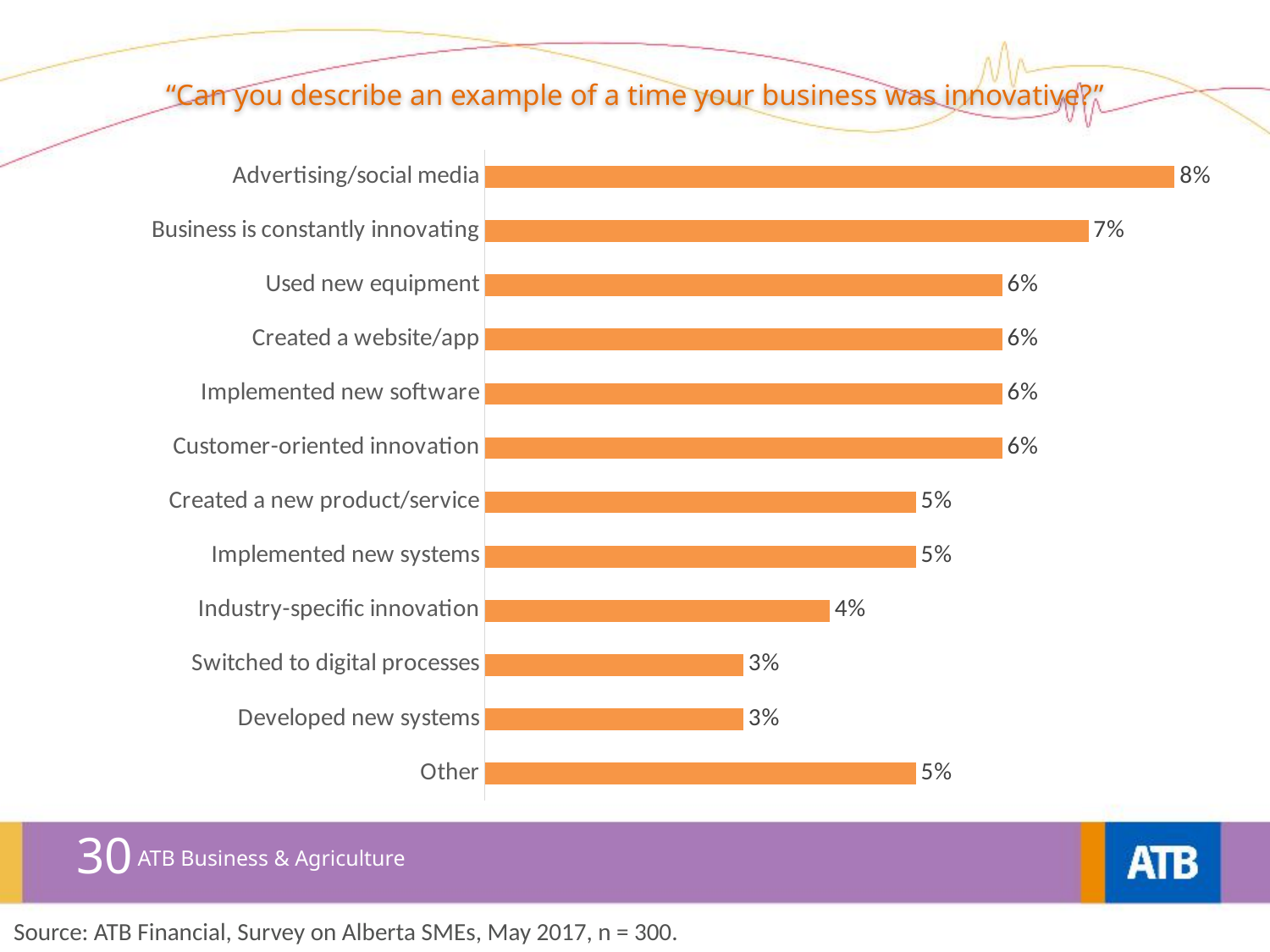
What is the difference between Used new equipment and Developed new systems? 3% What is the difference between Advertising/social media and Business is constantly innovating? 1% What is the title of the chart? "Can you describe an example of a time your business was innovative?" What percentage is shown for Switched to digital processes? 3% What type of chart is shown on the slide? Bar chart How many categories are shown in the chart? 12 What is the value for Other? 5% What is the value for Industry-specific innovation? 4% Which is larger, Business is constantly innovating or Customer-oriented innovation? Business is constantly innovating What percentage is shown for Advertising/social media? 8% Which category has the highest value? Advertising/social media Which is larger, Created a new product/service or Industry-specific innovation? Created a new product/service